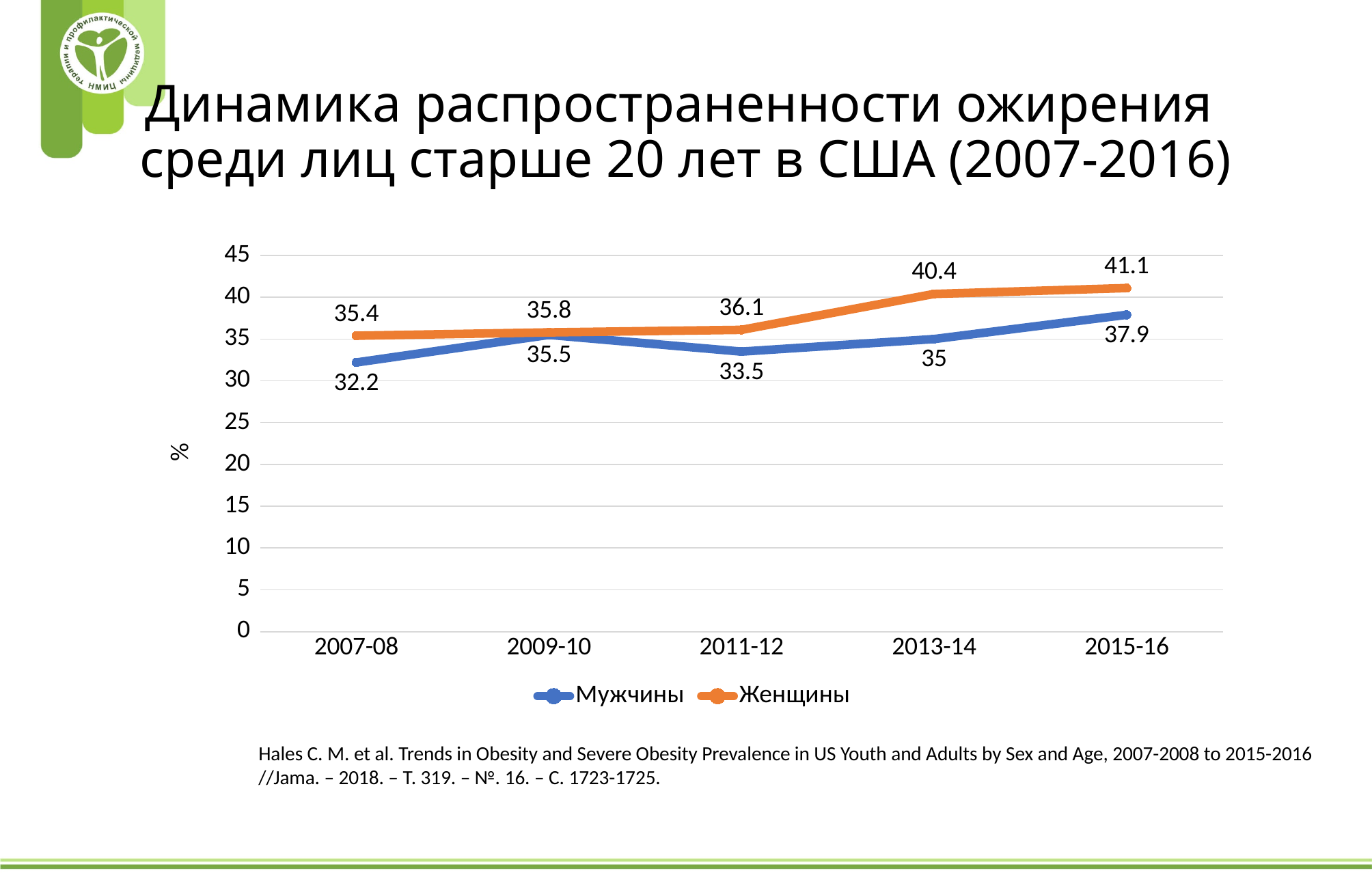
In which period is the value for Женщины highest? 2015-16 What is the value for Мужчины in 2007-08? 32.2 Which is larger in 2013-14, Мужчины or Женщины? Женщины How many series does the legend list? 2 What is the value for Женщины in 2013-14? 40.4 What is the value for Мужчины in 2011-12? 33.5 In which period is the value for Мужчины lowest? 2007-08 Is the value for Женщины in 2015-16 greater or less than 40? greater Does the value for Женщины rise or fall from 2007-08 to 2015-16? rise What kind of chart is shown on the slide? line chart What is the difference between Женщины and Мужчины in 2015-16? 3.2 How many time periods are shown on the x axis? 5